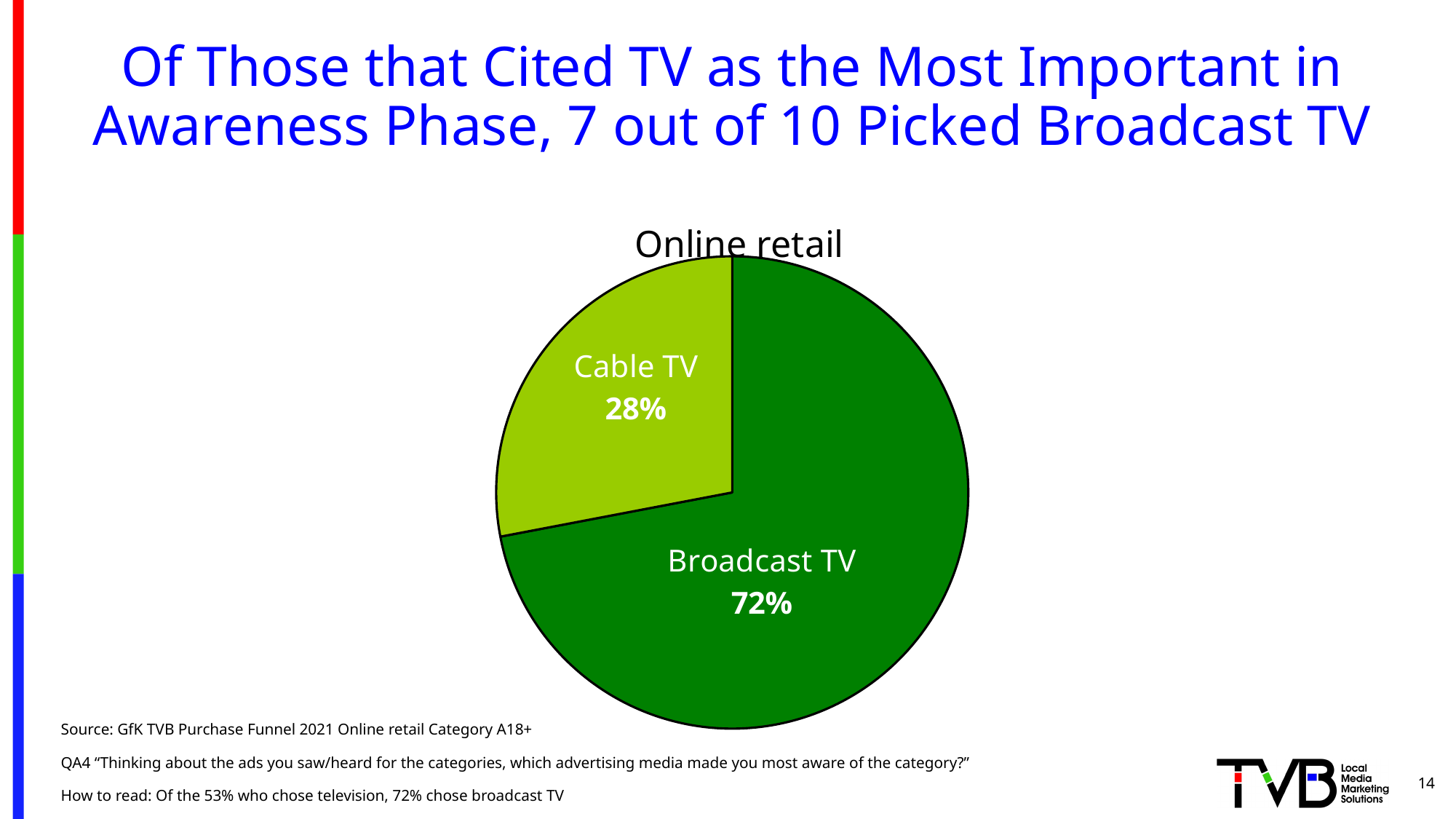
What is the difference in percentage points between the Broadcast TV and Cable TV slices? 44 Which slice of the pie is the largest? Broadcast TV Which slice of the pie is shown in the lighter green colour? Cable TV What share of the pie does Cable TV hold? 28% What kind of chart is shown on the slide? Pie chart Which is larger, the Cable TV slice or the Broadcast TV slice? Broadcast TV What is the title of the pie chart? Online retail Is the Broadcast TV share greater or less than 50%? greater Which slice of the pie is the smallest? Cable TV What do the two slices of the pie add up to? 100% What share of the pie does Broadcast TV hold? 72% How many slices does the pie chart have? 2